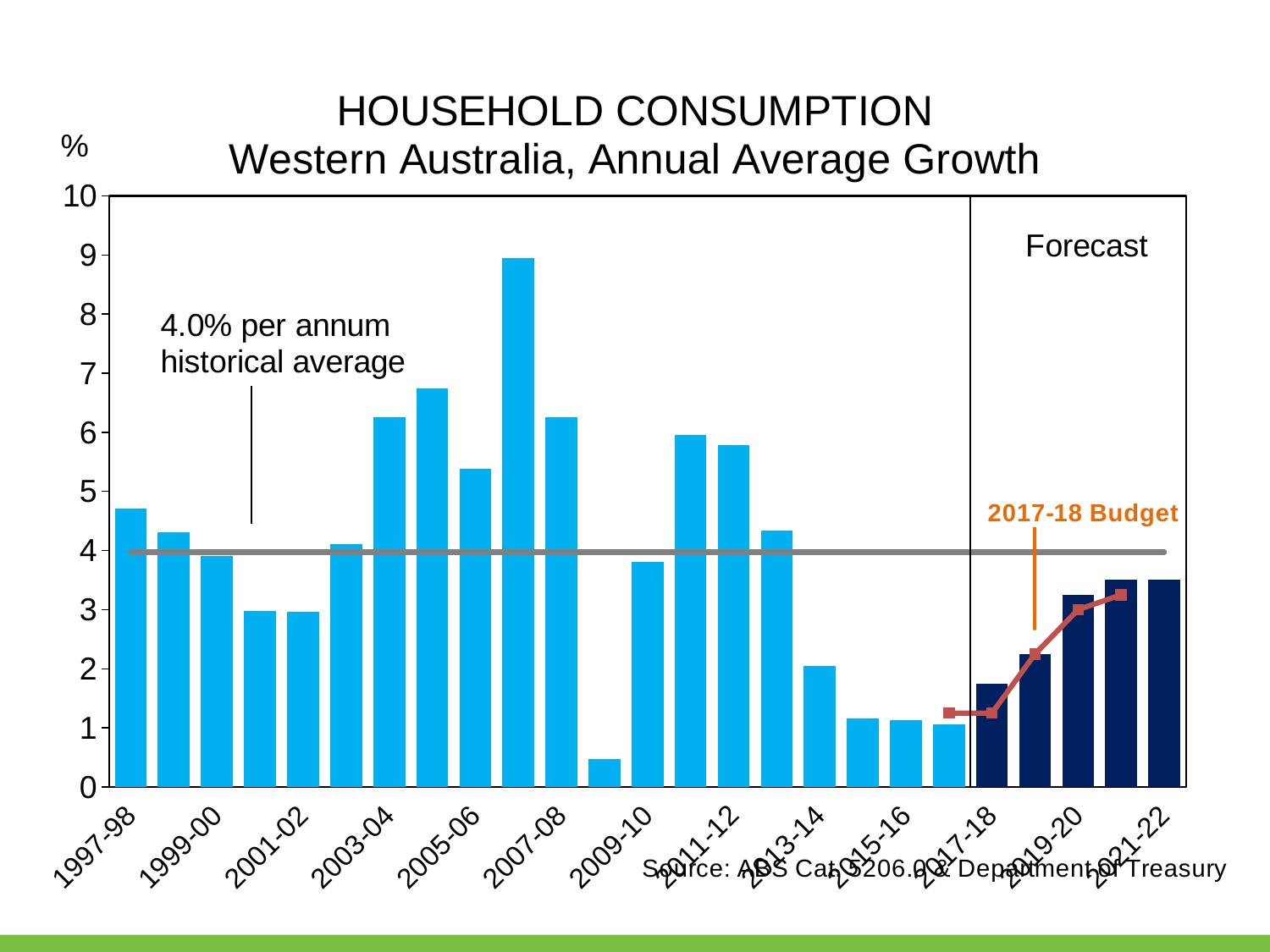
What kind of chart is shown on the slide? bar chart Which is larger, the value for 2003-04 or the value for 2009-10? 2003-04 Do the forecast bars from 2017-18 to 2021-22 rise or fall over time? rise Which is larger, the value for 1997-98 or the value for 2021-22? 1997-98 Is the value for 2011-12 greater or less than 5? greater What is the historical average growth rate shown by the horizontal line on the chart? 4.0% per annum Is the value for 2009-10 greater or less than 1? greater Is the value for 2021-22 greater or less than 4? less Which labelled year has the lowest household consumption growth on the chart? 2015-16